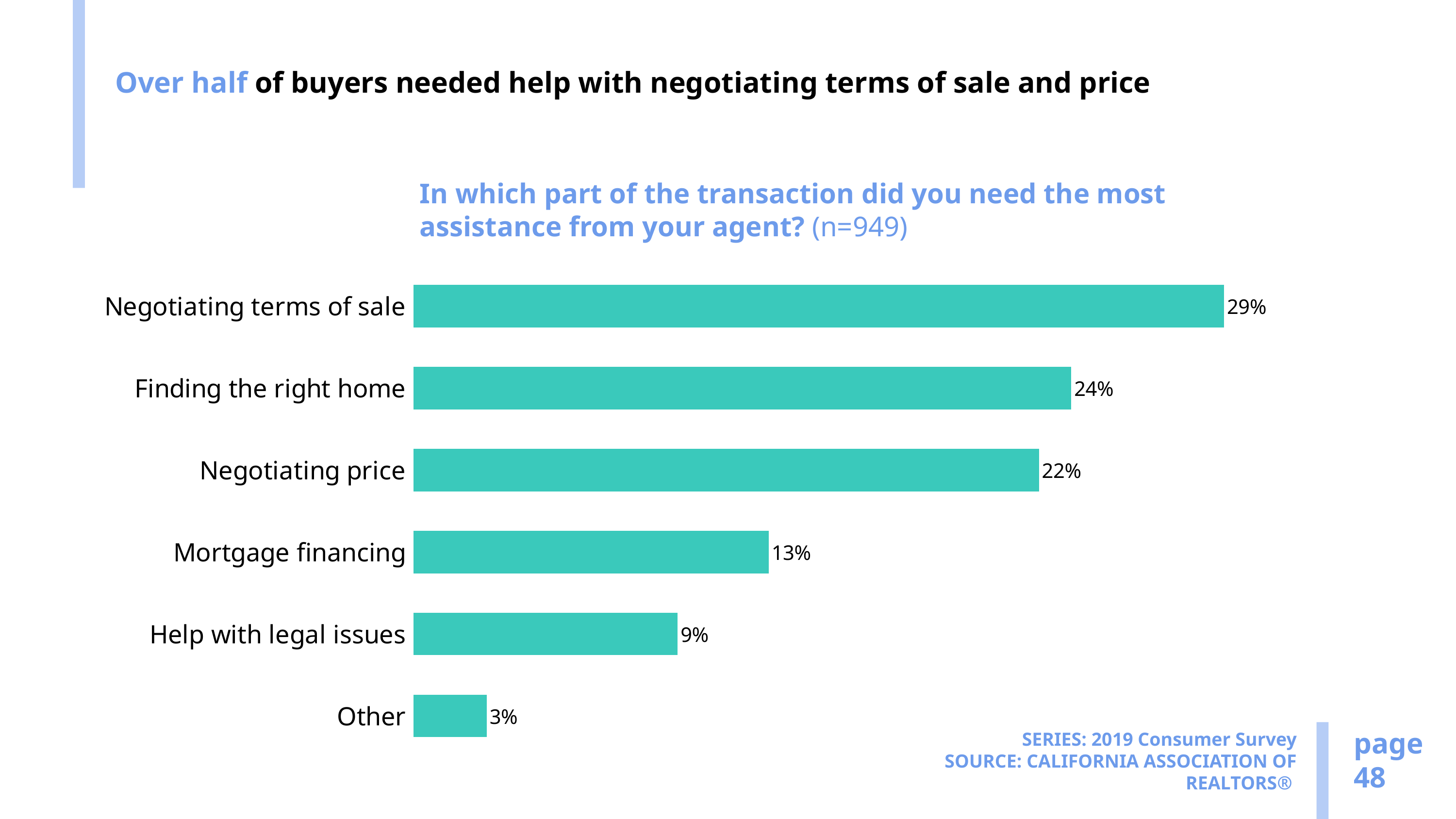
What percentage is shown for Mortgage financing? 13% How many categories are shown in the chart? 6 What kind of chart is shown on the slide? Bar chart Which category has the lowest value? Other What is the value for Help with legal issues? 9% What percentage of buyers needed the most assistance with negotiating terms of sale? 29% What is the sample size (n) stated in the chart title? 949 What is the difference between the values for Negotiating terms of sale and Negotiating price? 7% Which category has the highest value? Negotiating terms of sale What is the value shown for Finding the right home? 24% What is the difference between the values for Mortgage financing and Help with legal issues? 4% Which is larger, the value for Finding the right home or the value for Negotiating price? Finding the right home